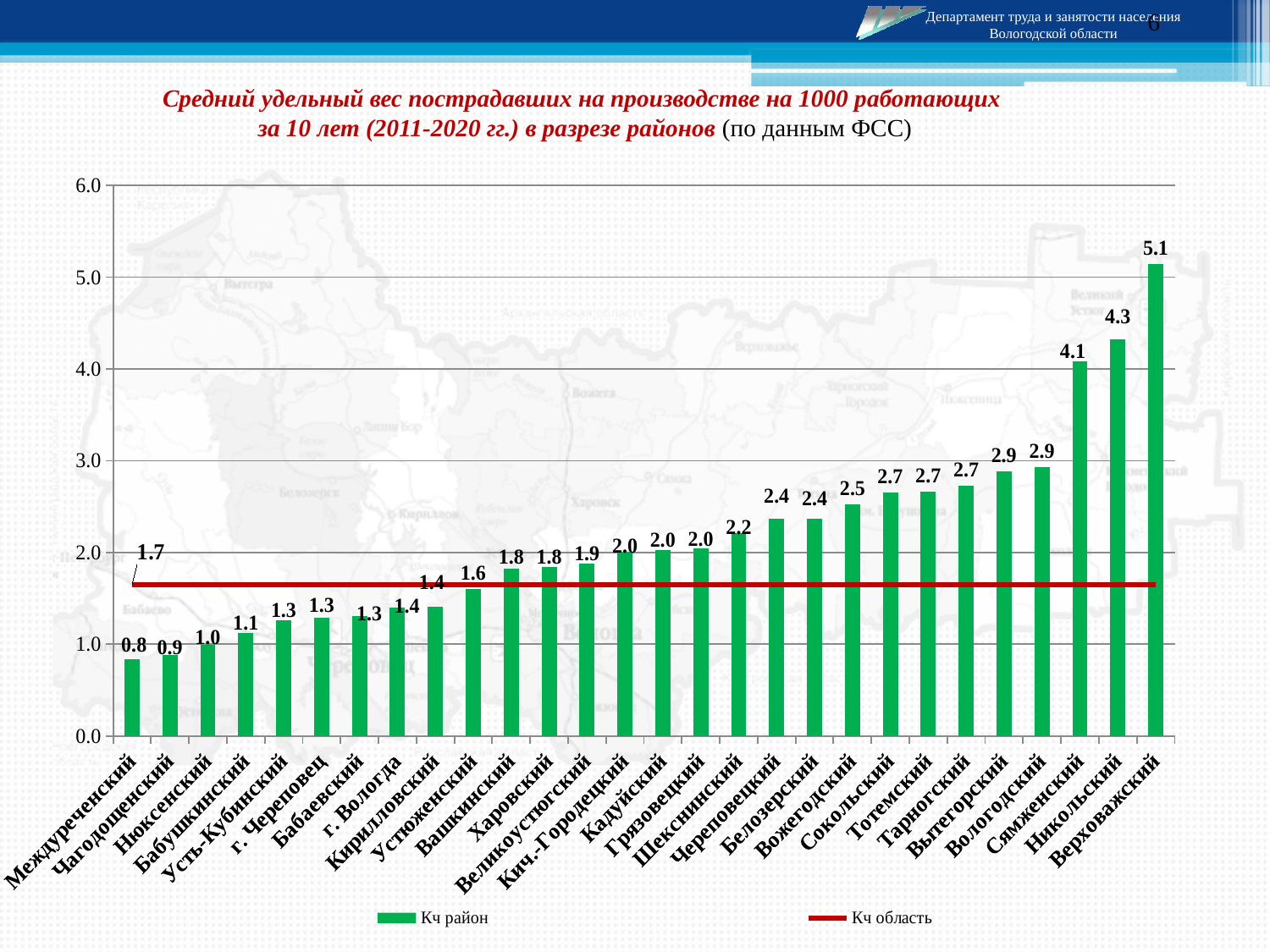
How many districts are shown on the x axis? 28 What is the value for г. Вологда? 1.4 What is the value of the red line labelled 'Кч область'? 1.7 What is the difference between the values for Верховажский and Никольский? 0.8 What is the value for Верховажский? 5.1 What kind of chart is this? combination bar and line chart Do the bar values rise or fall from left to right along the x axis? rise Is the value for Сямженский greater or less than 4.0? greater How many series does the legend list? 2 Which district has the lowest value? Междуреченский Which is larger, the value for Шекснинский or the value for Вожегодский? Вожегодский Which district has the highest value? Верховажский